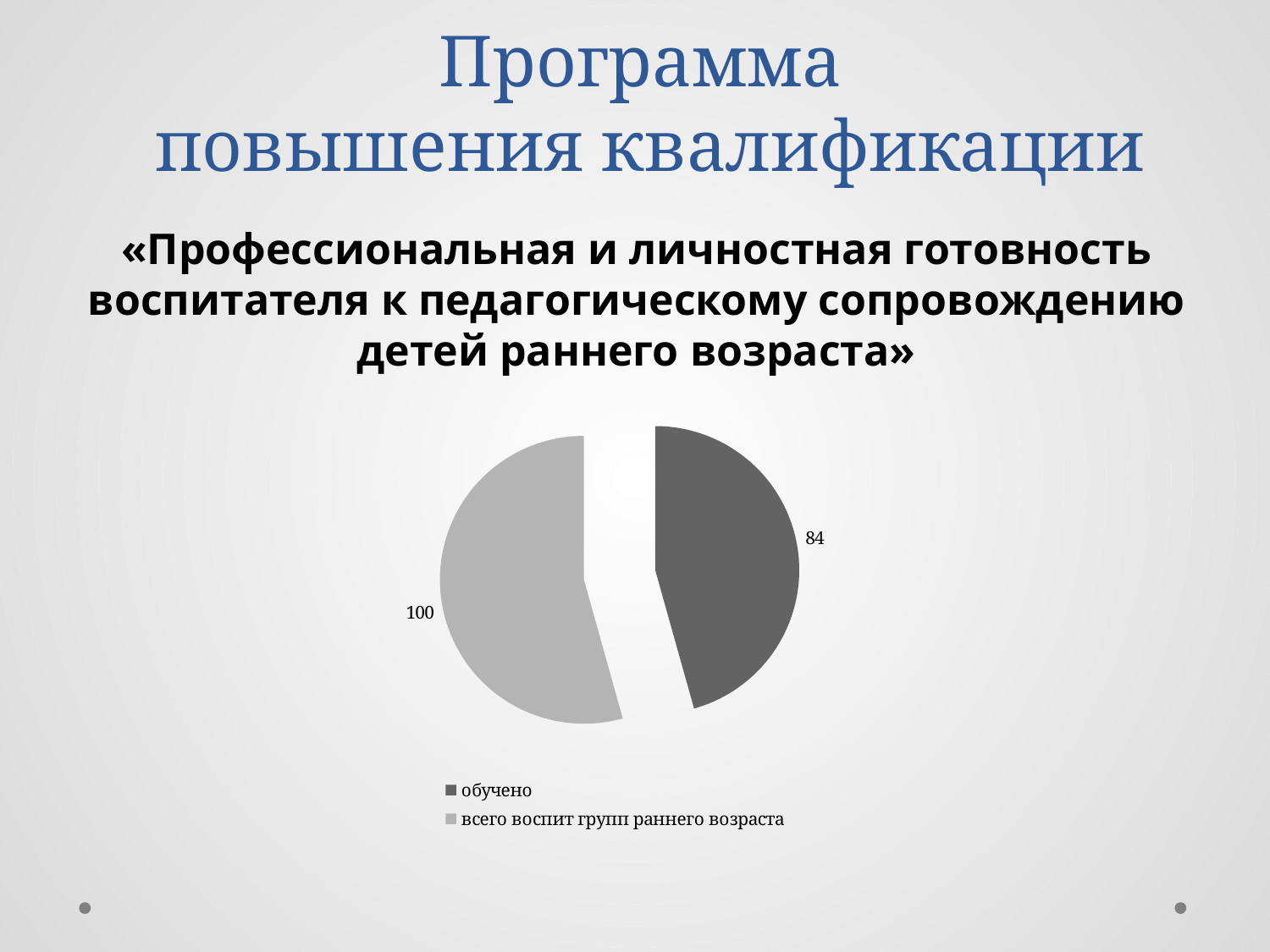
Which slice of the pie chart is the largest? всего воспит групп раннего возраста What value is shown for the "всего воспит групп раннего возраста" slice of the pie chart? 100 What is the difference between the "всего воспит групп раннего возраста" value and the "обучено" value? 16 What colour is the "обучено" slice of the pie chart? dark gray How many entries does the legend of the pie chart list? 2 What kind of chart is shown on the slide? pie chart What is the total of the two values shown on the pie chart? 184 Is the value for "обучено" greater or less than 100? less Which is larger: the value for "обучено" or the value for "всего воспит групп раннего возраста"? всего воспит групп раннего возраста How many slices does the pie chart have? 2 Which slice of the pie chart is the smallest? обучено What value is shown for the "обучено" slice of the pie chart? 84